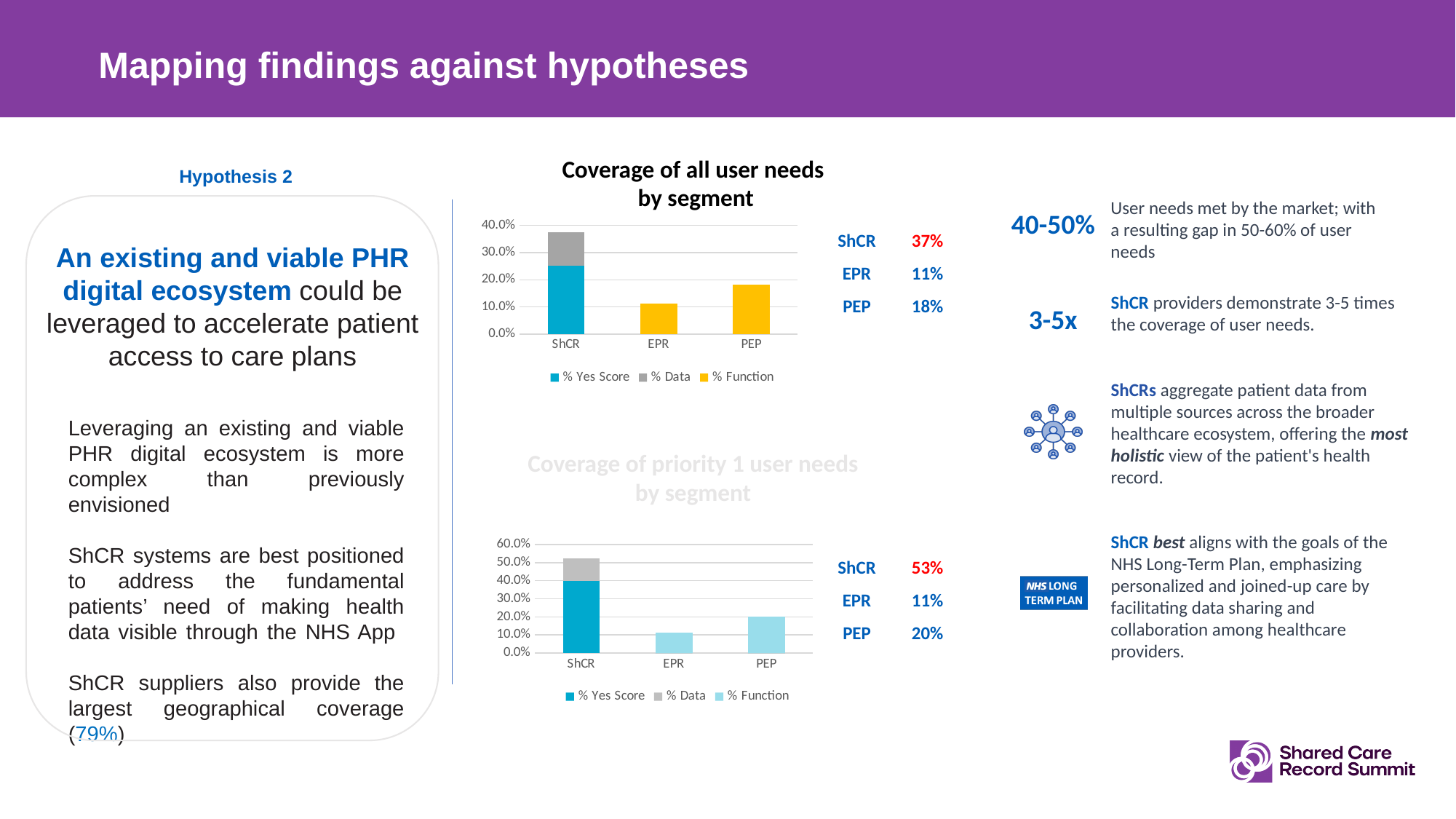
In the 'Coverage of all user needs by segment' chart, is the value for PEP greater or less than 20.0%? less In the 'Coverage of all user needs by segment' chart, what are the three legend entries? % Yes Score, % Data, % Function In the 'Coverage of all user needs by segment' chart, how many series does the legend list? 3 In the 'Coverage of all user needs by segment' chart, how many segments are shown on the x axis? 3 In the 'Coverage of all user needs by segment' chart, which segment has the highest total coverage? ShCR In the 'Coverage of priority 1 user needs by segment' chart, is the value for ShCR greater or less than 40.0%? greater In the 'Coverage of all user needs by segment' chart, what is the total coverage shown for ShCR? 37% In the 'Coverage of all user needs by segment' chart, which segment has the lowest total coverage? EPR In the 'Coverage of priority 1 user needs by segment' chart, what is the total coverage shown for ShCR? 53% In the 'Coverage of all user needs by segment' chart, what type of chart is shown? bar chart In the 'Coverage of priority 1 user needs by segment' chart, what is the difference between the ShCR total (53%) and the PEP value (20%)? 33 percentage points In the 'Coverage of priority 1 user needs by segment' chart, which is larger, the value for EPR or the value for PEP? PEP